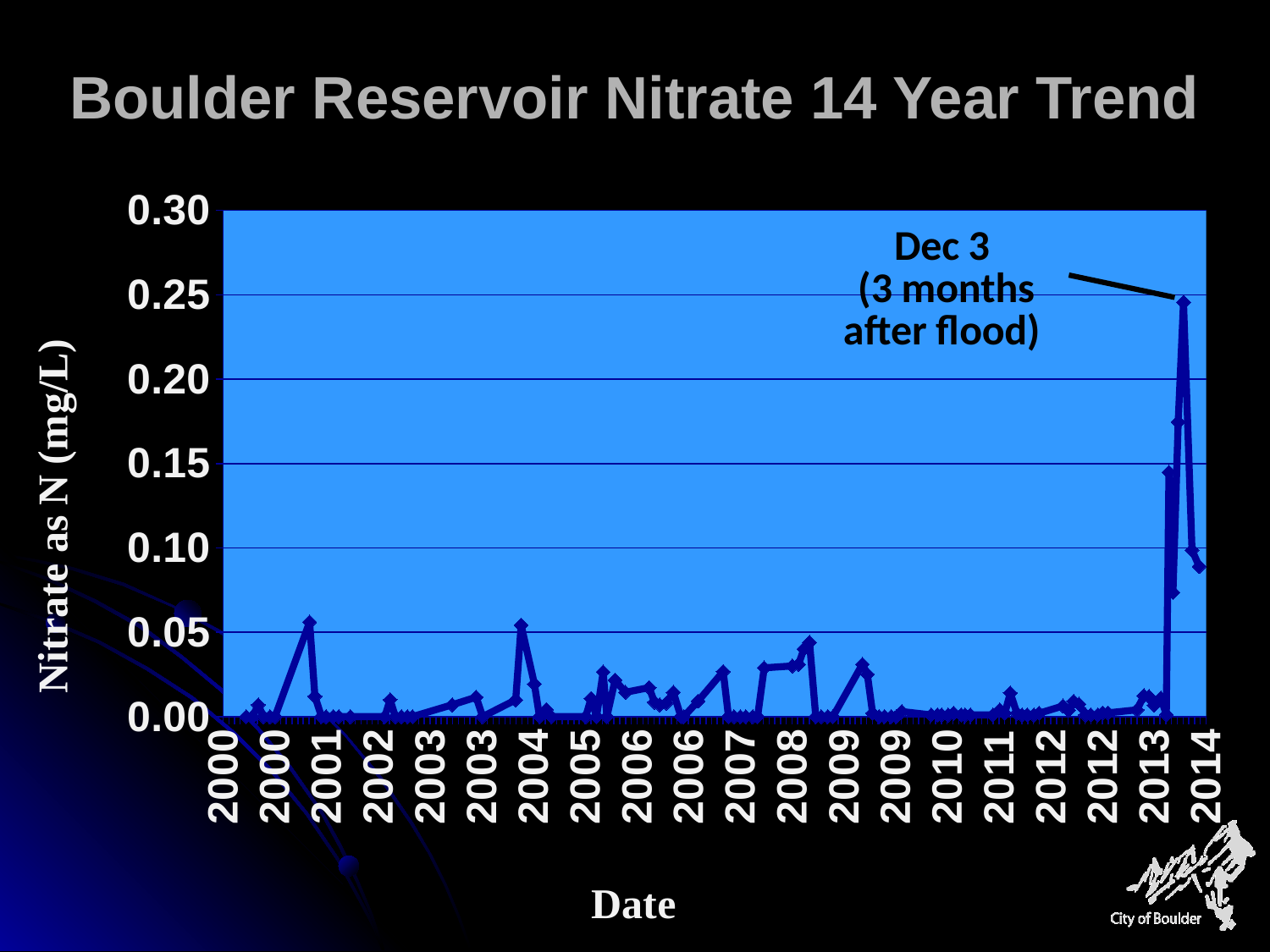
What kind of chart is shown on the slide? line chart What is the label on the vertical axis of the chart? Nitrate as N (mg/L) What is the highest value shown on the vertical axis? 0.30 After the Dec 3 peak, do the values rise or fall? fall What is the title of the chart? Boulder Reservoir Nitrate 14 Year Trend How many tick labels are shown on the vertical axis? 7 Is the value at the last plotted point in 2014 greater or less than 0.15? less Is the value at the last plotted point in 2014 greater or less than 0.05? greater Which annotated point is the highest value on the chart? Dec 3 (3 months after flood) Is the value at the Dec 3 peak greater or less than 0.20? greater